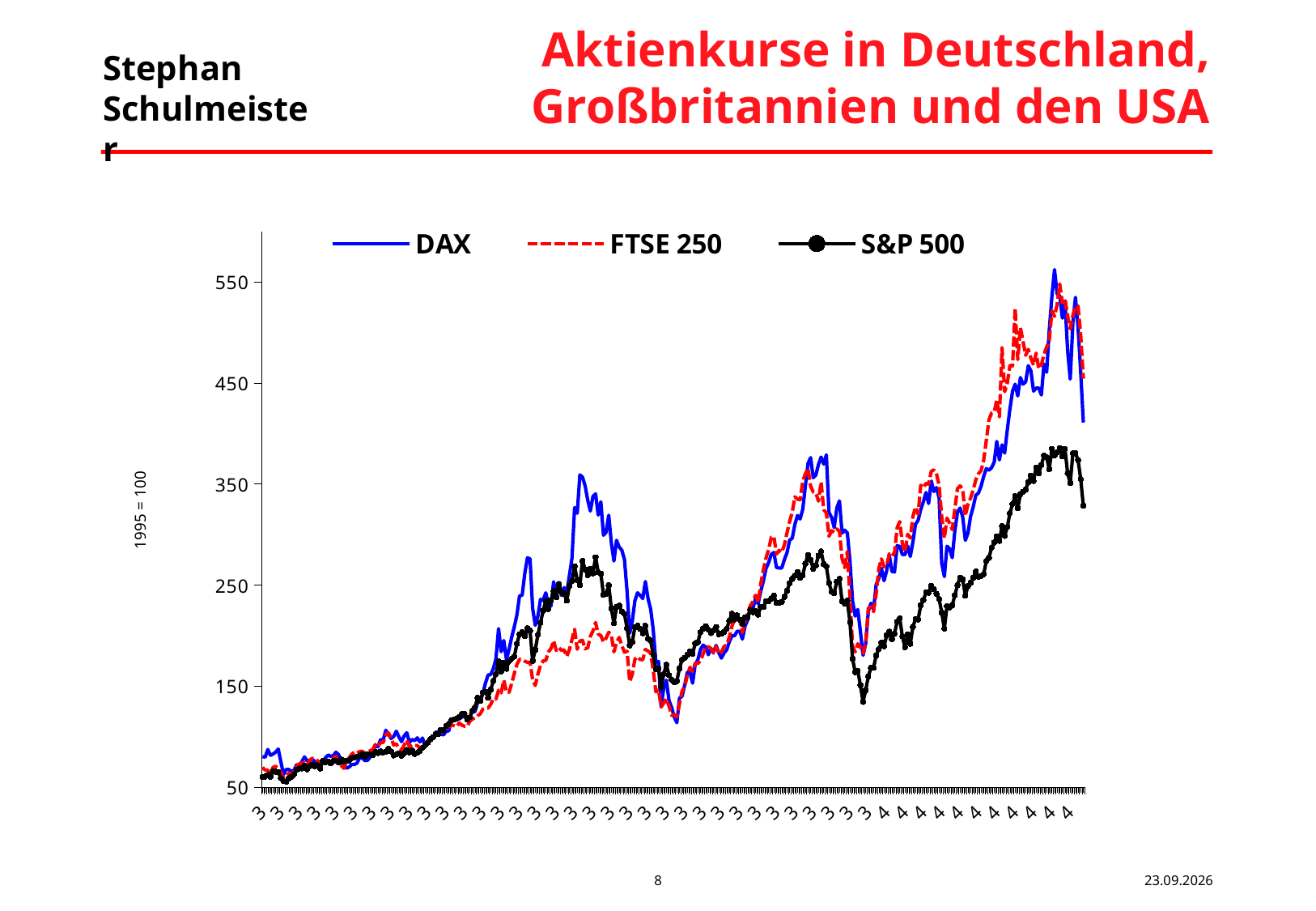
Overall, do the values of the three series rise or fall from left to right along the x axis? rise How many series does the legend list? 3 Which series reaches the highest peak on the chart? DAX Is the highest value reached by the S&P 500 greater or less than 450? less What kind of chart is shown on the slide? line chart Which series is lowest at the right-hand end of the chart? S&P 500 What is the label on the vertical axis of the chart? 1995 = 100 Which three series are listed in the legend? DAX, FTSE 250, S&P 500 At the right-hand end of the chart, is the DAX value greater or less than the S&P 500 value? greater Is the highest value reached by the FTSE 250 greater or less than 450? greater Are the values of all three series at the left-hand start of the chart greater or less than 150? less